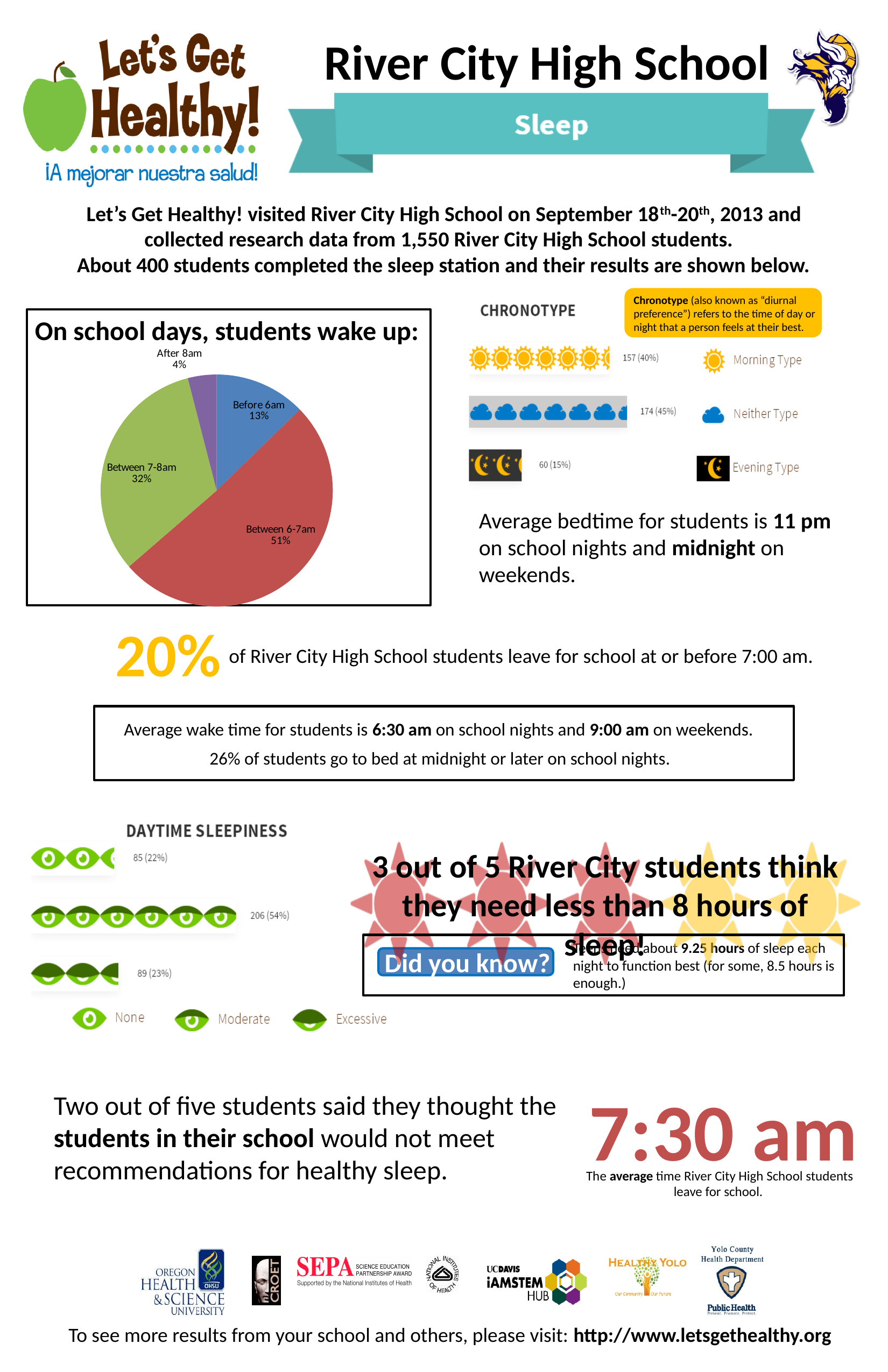
In the Chronotype chart, how many students are Morning Type? 157 (40%) In the pie chart 'On school days, students wake up:', what is the difference in percentage points between the 'Between 6-7am' and 'Between 7-8am' slices? 19 In the Daytime Sleepiness chart, how many students reported Moderate sleepiness? 206 (54%) In the pie chart 'On school days, students wake up:', which is larger: the 'Before 6am' slice or the 'Between 7-8am' slice? Between 7-8am In the Chronotype chart, which type has the fewest students? Evening Type What type of chart is used to show when students wake up on school days? Pie chart In the pie chart 'On school days, students wake up:', what percentage of students wake up between 6-7am? 51% How many categories are shown in the pie chart 'On school days, students wake up:'? 4 In the pie chart 'On school days, students wake up:', which wake-up time category has the smallest share? After 8am In the pie chart 'On school days, students wake up:', what percentage of students wake up after 8am? 4% In the pie chart 'On school days, students wake up:', which wake-up time category has the largest share? Between 6-7am In the pie chart 'On school days, students wake up:', what percentage of students wake up before 6am? 13%